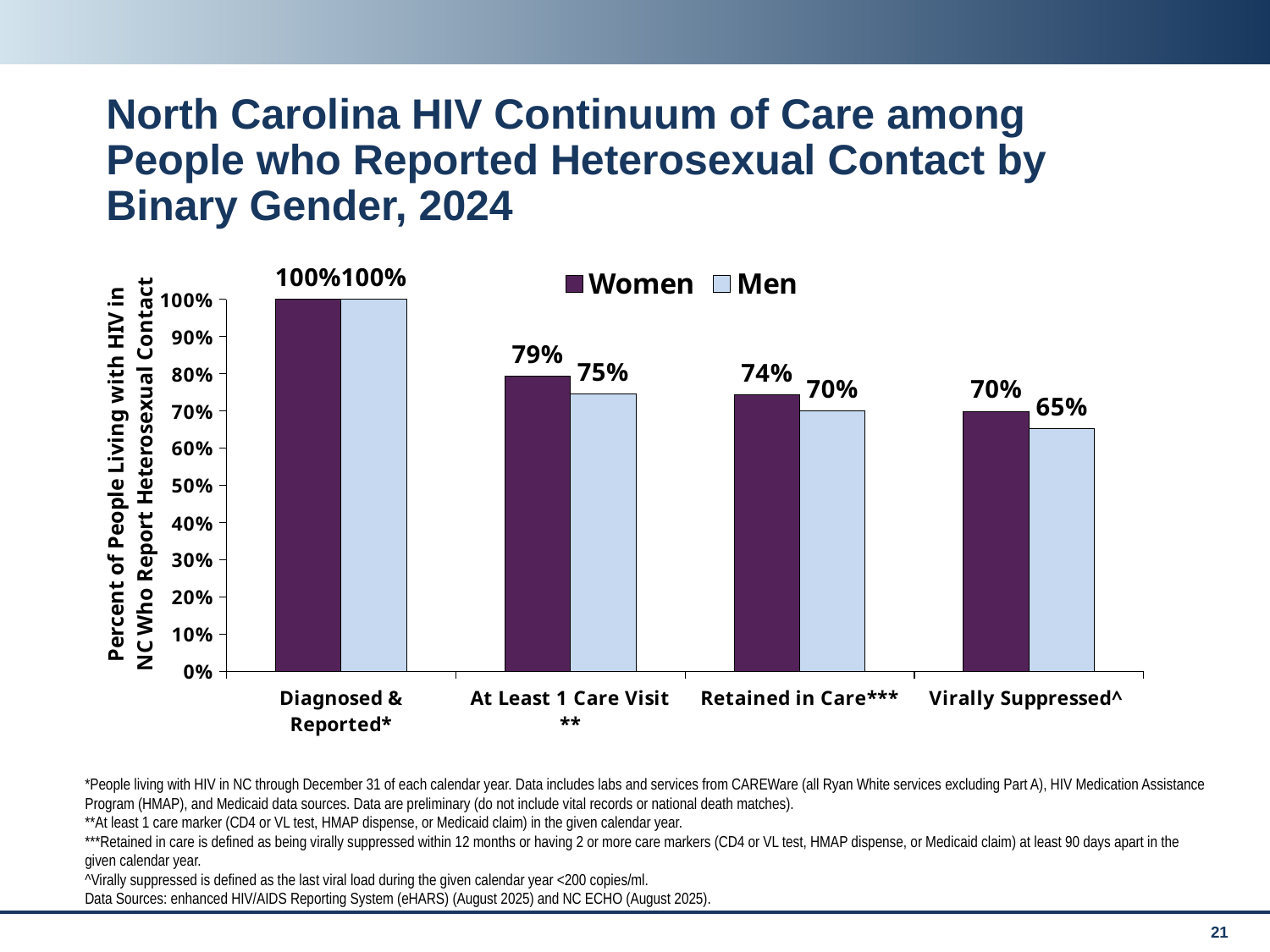
What is the value for Men in the Retained in Care category? 70% What is the value for Men in the Virally Suppressed category? 65% What kind of chart is shown on the slide? Bar chart Which category has the lowest value for Men? Virally Suppressed What is the value for Women in the Diagnosed & Reported category? 100% What is the value for Women in the At Least 1 Care Visit category? 79% How many categories are shown on the x axis? 4 What is the difference between the Women values for At Least 1 Care Visit and Virally Suppressed? 9% Do the Men values rise or fall from left to right across the categories? Fall How many series does the legend list? 2 Which is larger, the Women value or the Men value for Virally Suppressed? Women What is the difference between the Women and Men values in the Retained in Care category? 4%